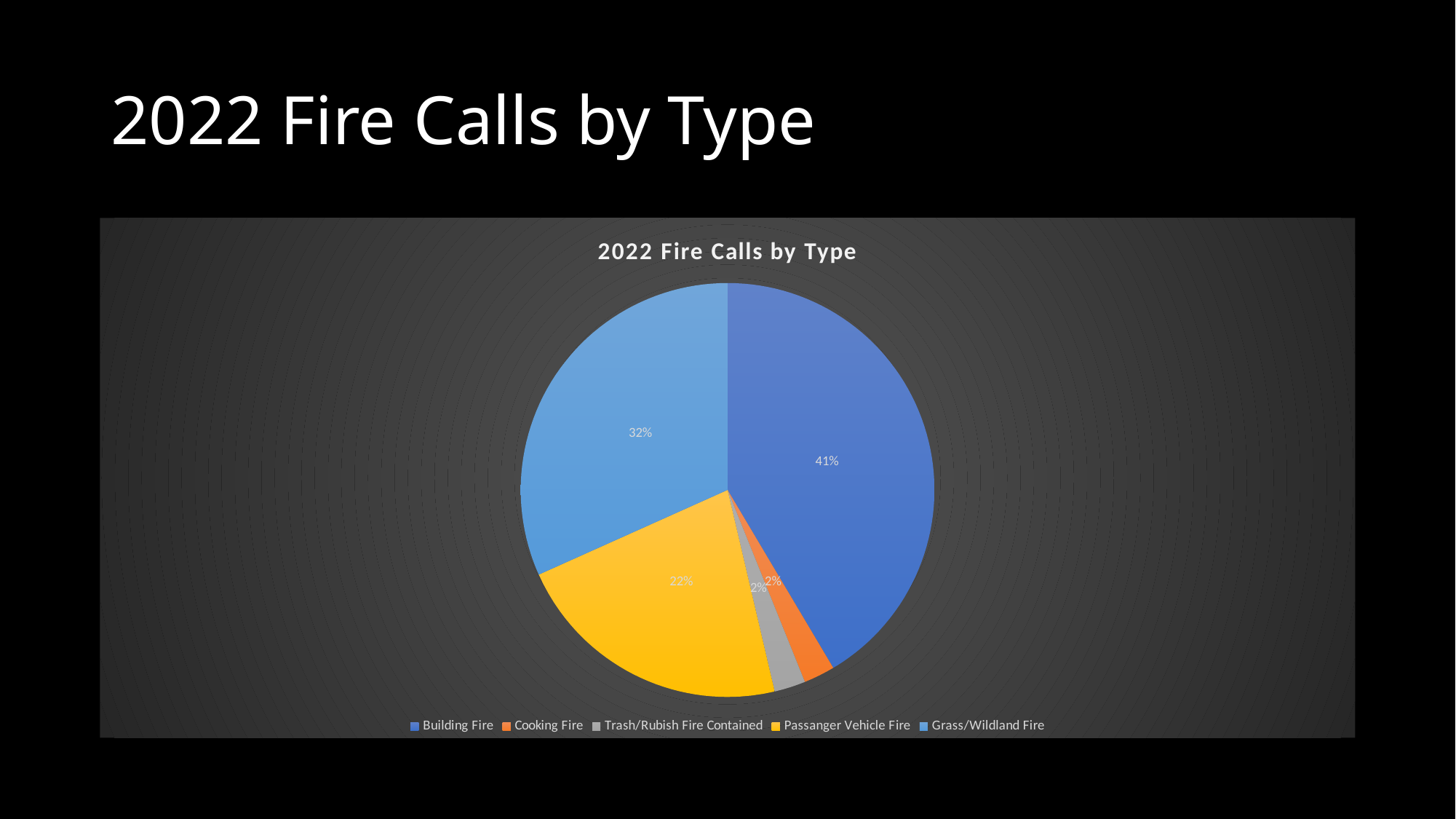
What share of 2022 fire calls were Passanger Vehicle Fire? 22% What share of 2022 fire calls were Trash/Rubish Fire Contained? 2% What is the title of the chart? 2022 Fire Calls by Type What share of 2022 fire calls were Building Fire? 41% Which colour represents Passanger Vehicle Fire in the legend? yellow Which is larger, the share for Grass/Wildland Fire or the share for Passanger Vehicle Fire? Grass/Wildland Fire Which fire call type has the largest share of the pie? Building Fire What type of chart is shown on the slide? pie chart How many categories does the pie chart show? 5 What is the difference in percentage points between the Building Fire share and the Grass/Wildland Fire share? 9%